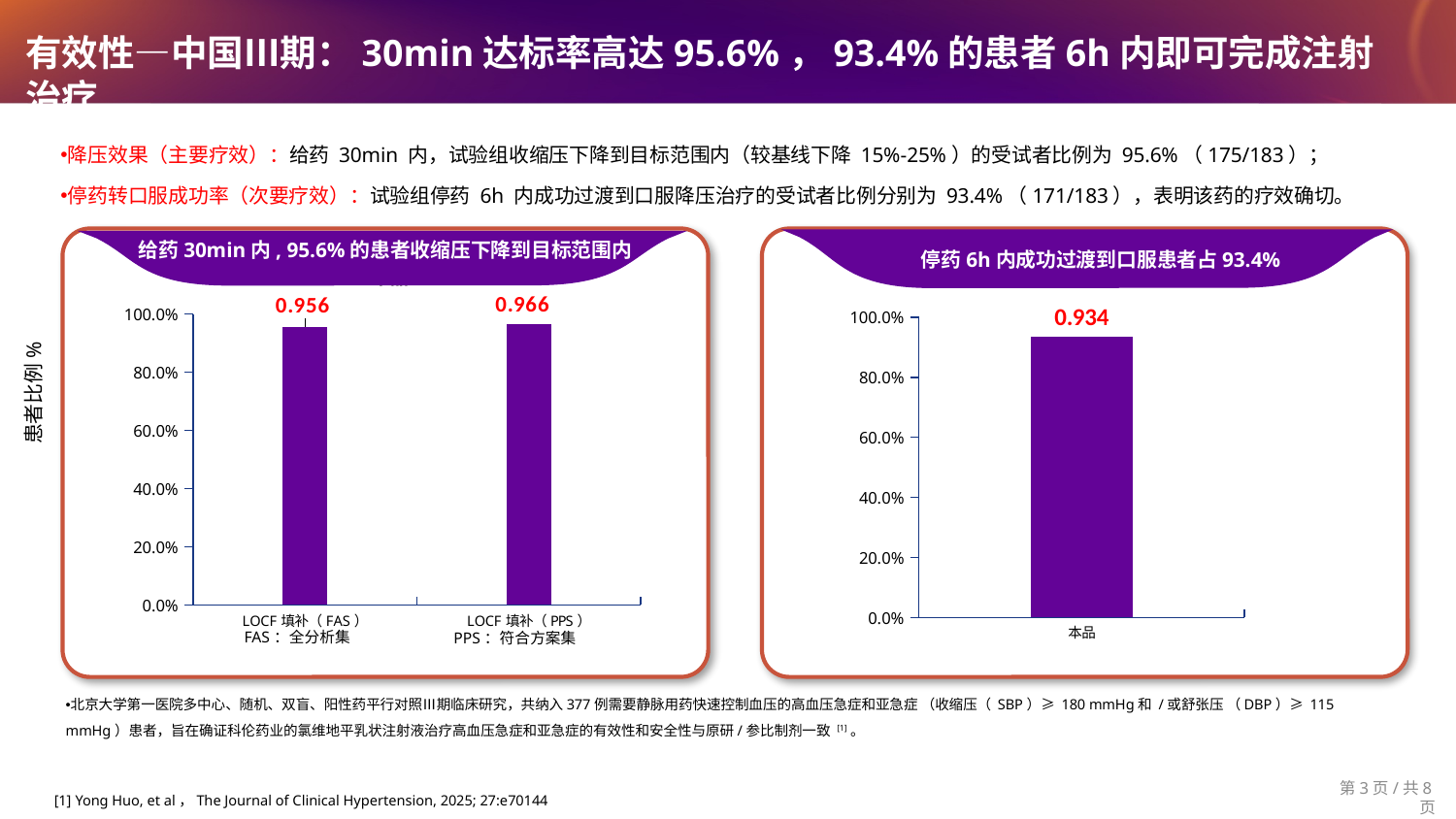
In the right chart (停药 6h 内), what is the value for 本品? 0.934 In the left chart (给药 30min 内), how many bars are plotted? 2 In the left chart (给药 30min 内), which category has the higher value? LOCF 填补（PPS） In the left chart (给药 30min 内), what is the difference between the PPS and FAS values? 0.010 Is the value for LOCF 填补（FAS） in the left chart larger or smaller than the value for 本品 in the right chart? larger In the left chart (给药 30min 内), which category has the lower value? LOCF 填补（FAS） In the right chart (停药 6h 内), is the value for 本品 greater or less than 80.0%? greater In the right chart (停药 6h 内), how many bars are plotted? 1 What is the y-axis label shown to the left of the charts? 患者比例 % In the left chart (给药 30min 内), what is the value for LOCF 填补（PPS）? 0.966 What type of chart is the right chart (停药 6h 内)? Bar chart In the left chart (给药 30min 内), what is the value for LOCF 填补（FAS）? 0.956